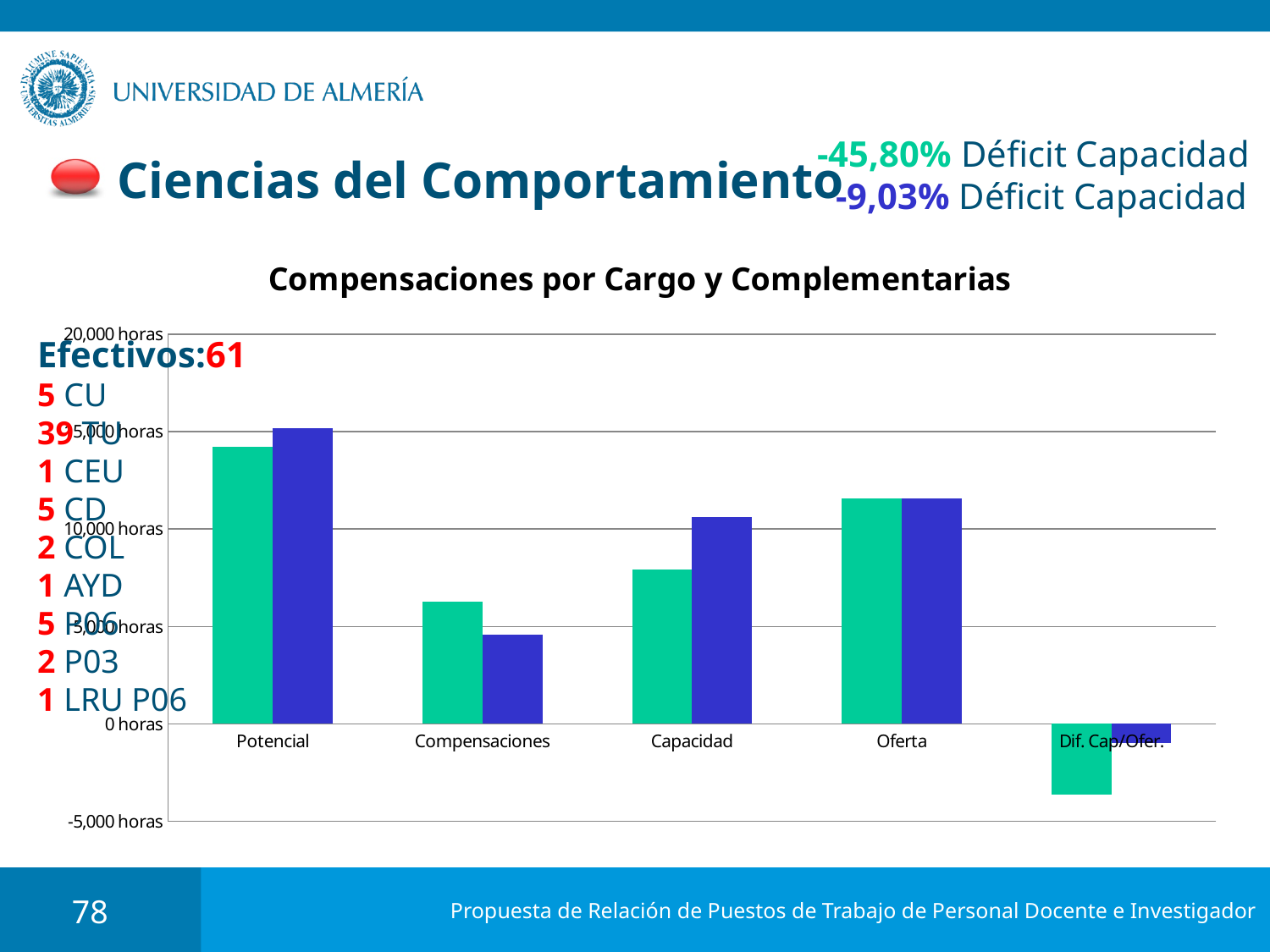
Which green bar is larger, Potencial or Oferta? Potencial Is the green bar for Compensaciones greater or less than 5,000 horas? greater For Compensaciones, which bar is larger, the green one or the blue one? the green one Is the green bar for Potencial greater or less than 10,000 horas? greater How many categories are shown on the x axis of the chart? 5 Is the blue bar for Compensaciones greater or less than 5,000 horas? less What is the title of the chart? Compensaciones por Cargo y Complementarias What kind of chart is shown on the slide? bar chart Which category has the tallest green bar? Potencial Which category has the lowest green bar? Dif. Cap/Ofer. For Capacidad, which bar is larger, the green one or the blue one? the blue one